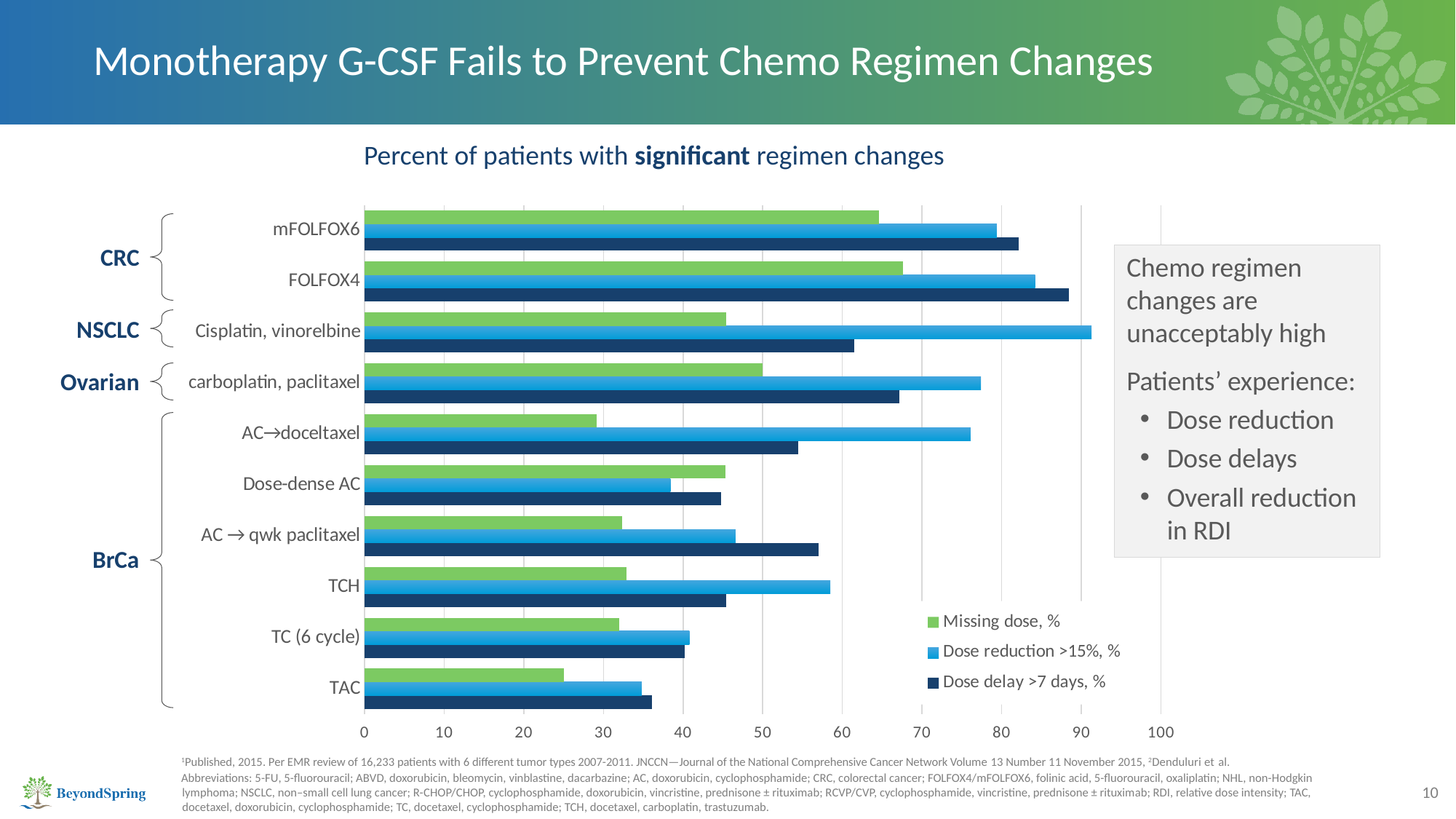
For AC→doceltaxel, which is larger: Dose reduction >15% or Dose delay >7 days? Dose reduction >15% Which regimen has the highest value for Dose reduction >15%, %? Cisplatin, vinorelbine How many chemotherapy regimens are plotted on the chart? 10 For Cisplatin, vinorelbine, which is larger: Missing dose or Dose reduction >15%? Dose reduction >15% What kind of chart is shown on the slide? bar chart Which regimen has the lowest value for Missing dose, %? TAC What is the subtitle printed above the chart? Percent of patients with significant regimen changes Is the Dose reduction >15% value for Cisplatin, vinorelbine greater or less than 80? greater Is the Missing dose value for TAC greater or less than 30? less How many series does the legend list? 3 Which regimen has the highest value for Dose delay >7 days, %? FOLFOX4 Is the Dose delay >7 days value for Dose-dense AC greater or less than 50? less